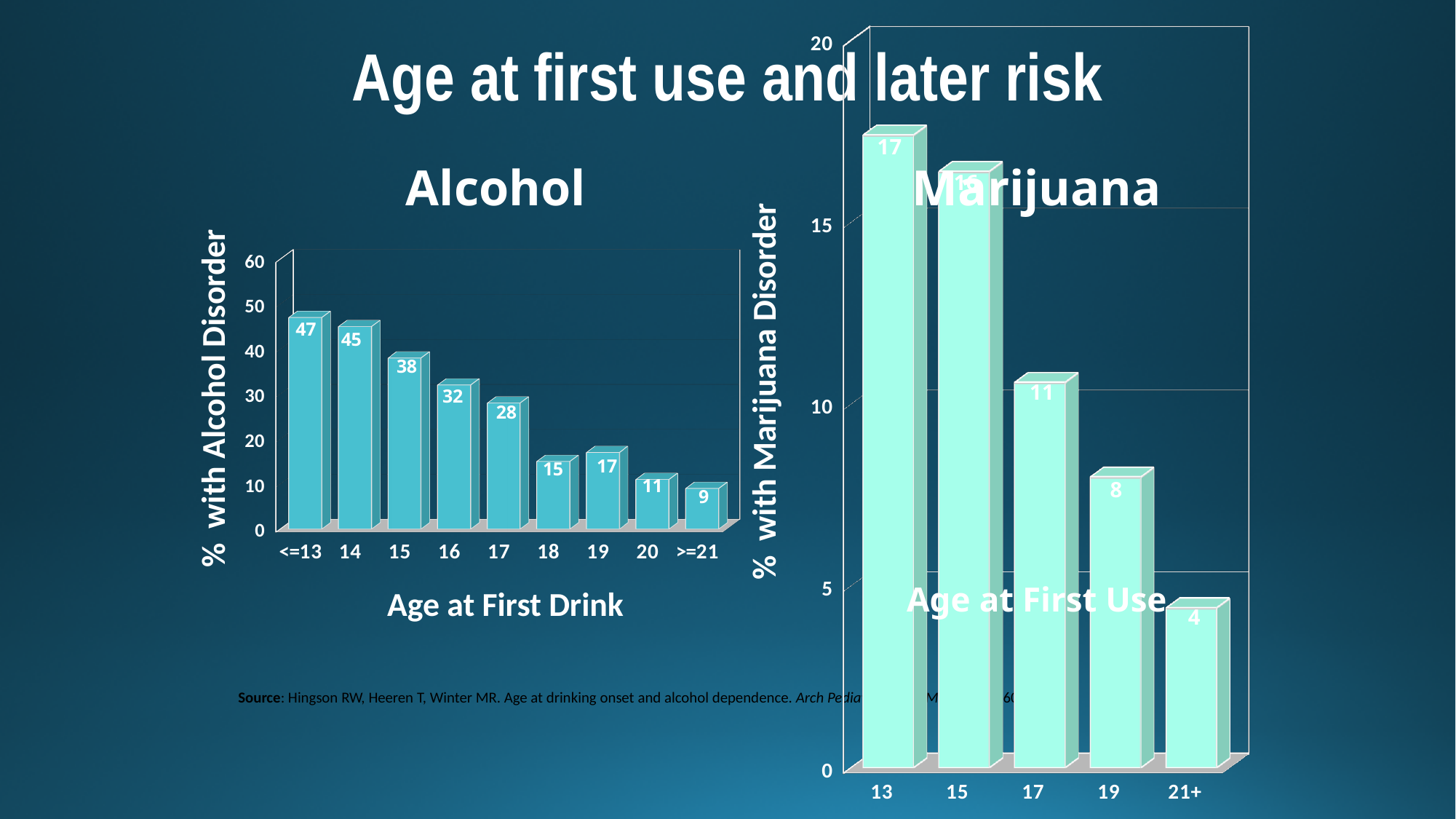
On the Marijuana chart, what is the value for age at first use 21+? 4 On the Marijuana chart, what is the value for age at first use 13? 17 On the Alcohol chart, what is the value for age at first drink 16? 32 On the Alcohol chart, which age at first drink has the highest % with alcohol disorder? <=13 How many age categories are shown on the Marijuana chart? 5 On the Marijuana chart, what is the difference between the values for age 17 and age 19? 3 How many age categories are shown on the Alcohol chart? 9 On the Alcohol chart, which is larger, the value for age 18 or the value for age 19? 19 What kind of chart is the Marijuana chart? bar chart On the Alcohol chart, what is the difference between the values for age 15 and age 17? 10 On the Alcohol chart, what is the value for age at first drink <=13? 47 On the Alcohol chart, which age at first drink has the lowest % with alcohol disorder? >=21